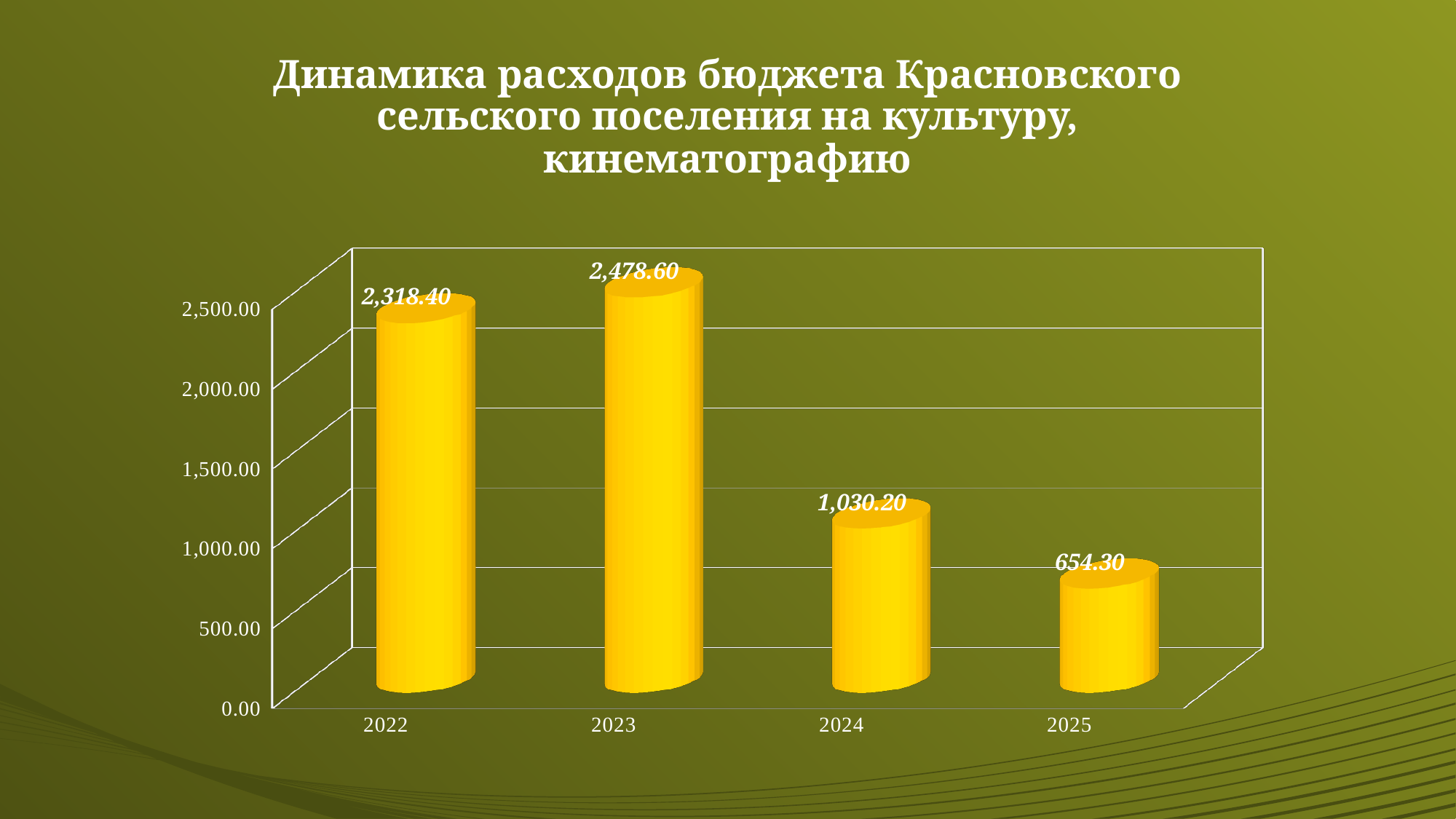
Is the value for 2025 greater or less than 1,000.00? less What kind of chart is shown on the slide? bar chart What is the value for 2025? 654.30 What is the value for 2024? 1,030.20 Which year has the highest value? 2023 How many years are shown on the x axis? 4 What is the difference between the values for 2023 and 2022? 160.20 What is the value for 2023? 2,478.60 What is the value for 2022? 2,318.40 What is the difference between the values for 2024 and 2025? 375.90 Which is larger, the value for 2022 or the value for 2024? 2022 Which year has the lowest value? 2025